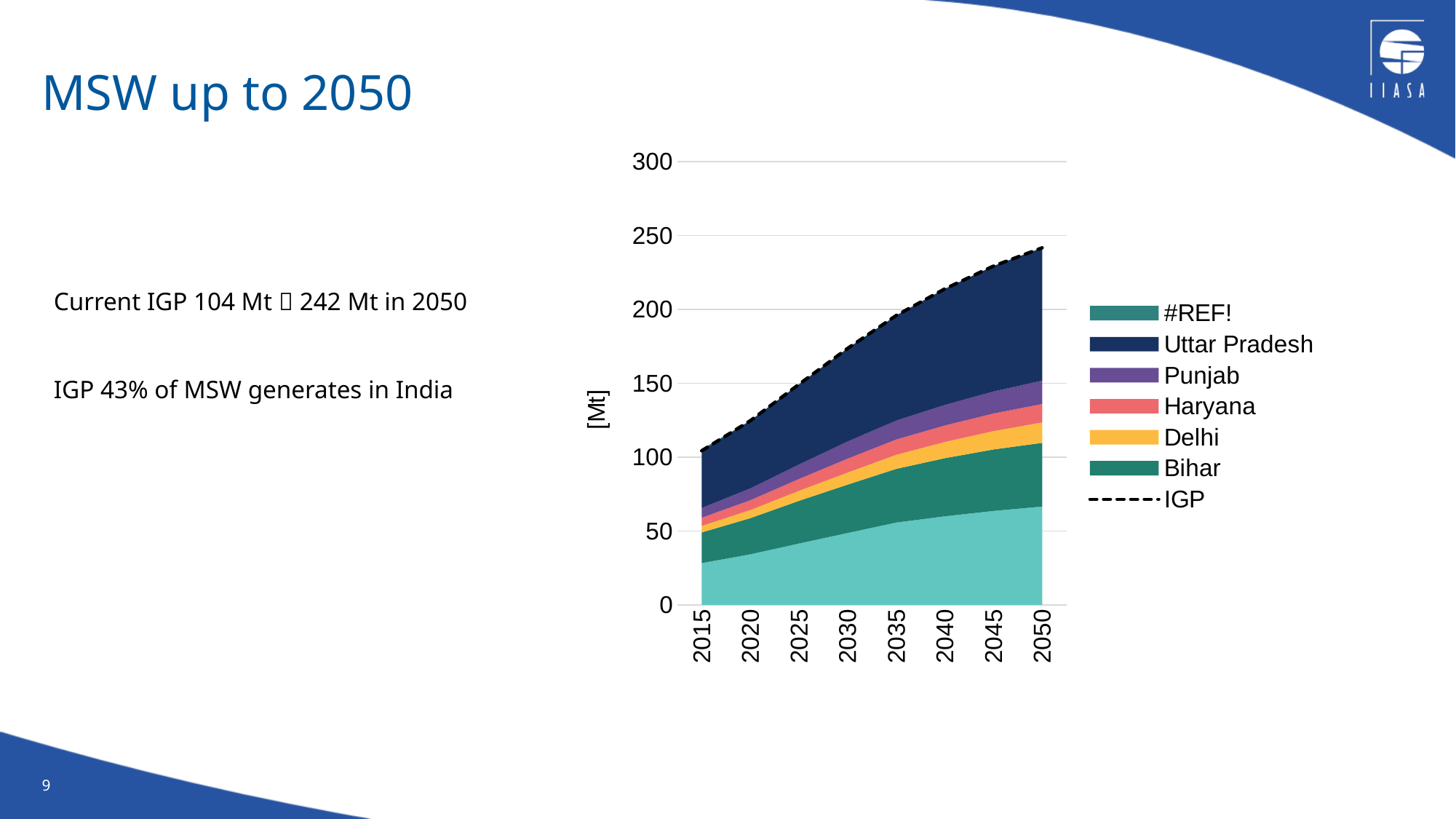
Is the IGP value in 2015 greater or less than 150? less According to the slide, what is the IGP value in 2050? 242 Mt Which legend entry is drawn as a dashed line? IGP In 2050, which contributes more to the stack, Uttar Pradesh or Delhi? Uttar Pradesh Is the total stacked value in 2030 greater or less than 150? greater Is the IGP value in 2050 greater or less than 200? greater How many year labels are shown on the x axis? 8 How many entries does the chart legend list? 7 What kind of chart is shown on the slide? area chart Does the IGP line rise or fall from 2015 to 2050? rise What is the title of the slide containing the chart? MSW up to 2050